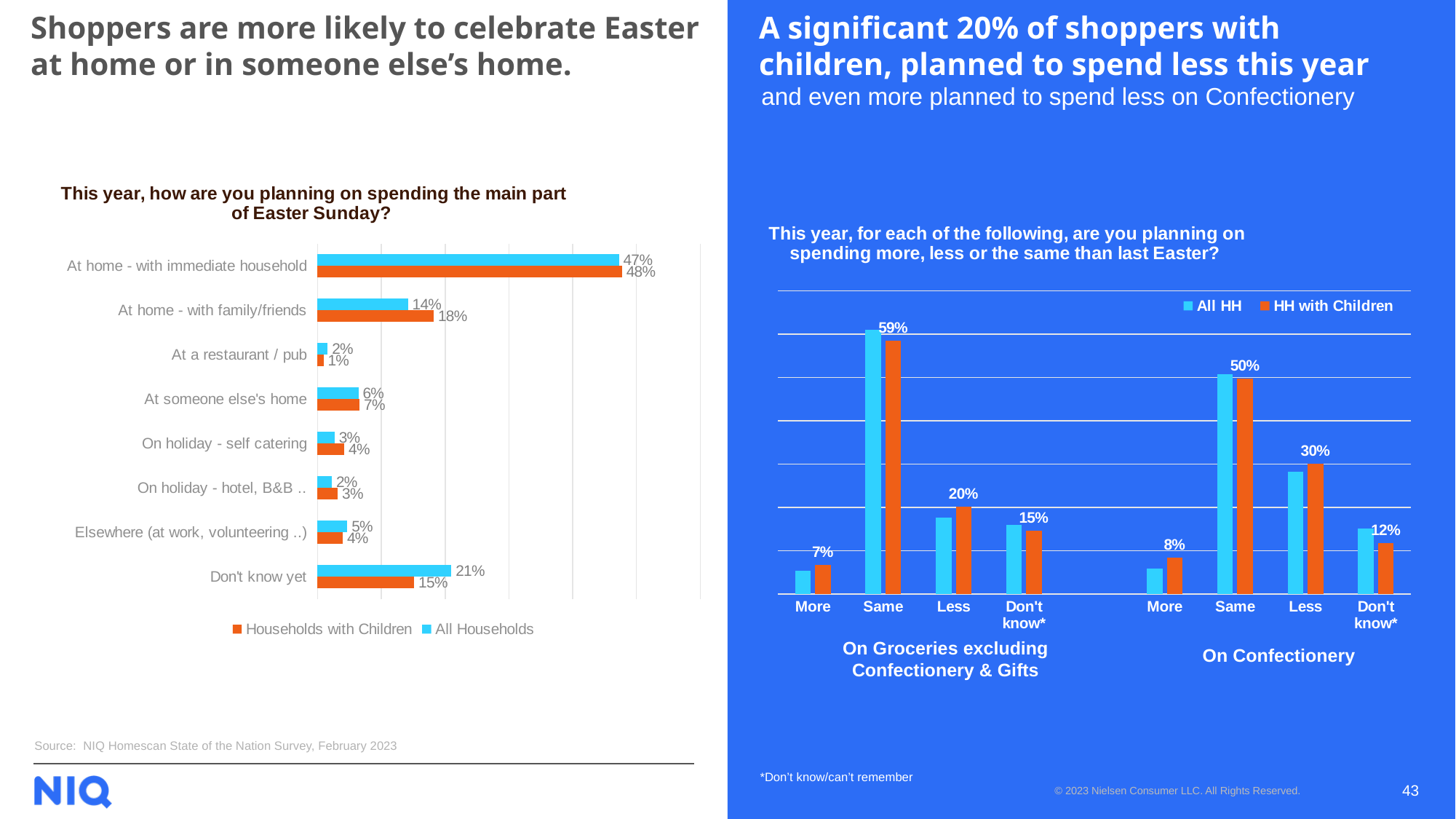
In the left chart 'This year, how are you planning on spending the main part of Easter Sunday?', what is the value for 'At home - with family/friends' for Households with Children? 18% In the left chart 'This year, how are you planning on spending the main part of Easter Sunday?', what is the difference between All Households and Households with Children for 'Don't know yet'? 6% In the left chart 'This year, how are you planning on spending the main part of Easter Sunday?', what is the value for 'At home - with immediate household' for All Households? 47% In the right chart 'This year, for each of the following, are you planning on spending more, less or the same than last Easter?', what is the value for 'Less' on Groceries excluding Confectionery & Gifts for HH with Children? 20% How many series does the legend of the right chart 'This year, for each of the following, are you planning on spending more, less or the same than last Easter?' list? 2 In the left chart 'This year, how are you planning on spending the main part of Easter Sunday?', which is larger for 'At home - with family/friends': All Households or Households with Children? Households with Children In the right chart 'This year, for each of the following, are you planning on spending more, less or the same than last Easter?', which response has the highest value for On Confectionery? Same What kind of chart is the left chart 'This year, how are you planning on spending the main part of Easter Sunday?'? Bar chart How many categories are shown in the left chart 'This year, how are you planning on spending the main part of Easter Sunday?'? 8 In the right chart 'This year, for each of the following, are you planning on spending more, less or the same than last Easter?', what is the value for 'Less' on Confectionery for HH with Children? 30% In the left chart 'This year, how are you planning on spending the main part of Easter Sunday?', which category has the highest value for All Households? At home - with immediate household In the left chart 'This year, how are you planning on spending the main part of Easter Sunday?', what is the value for 'Don't know yet' for Households with Children? 15%